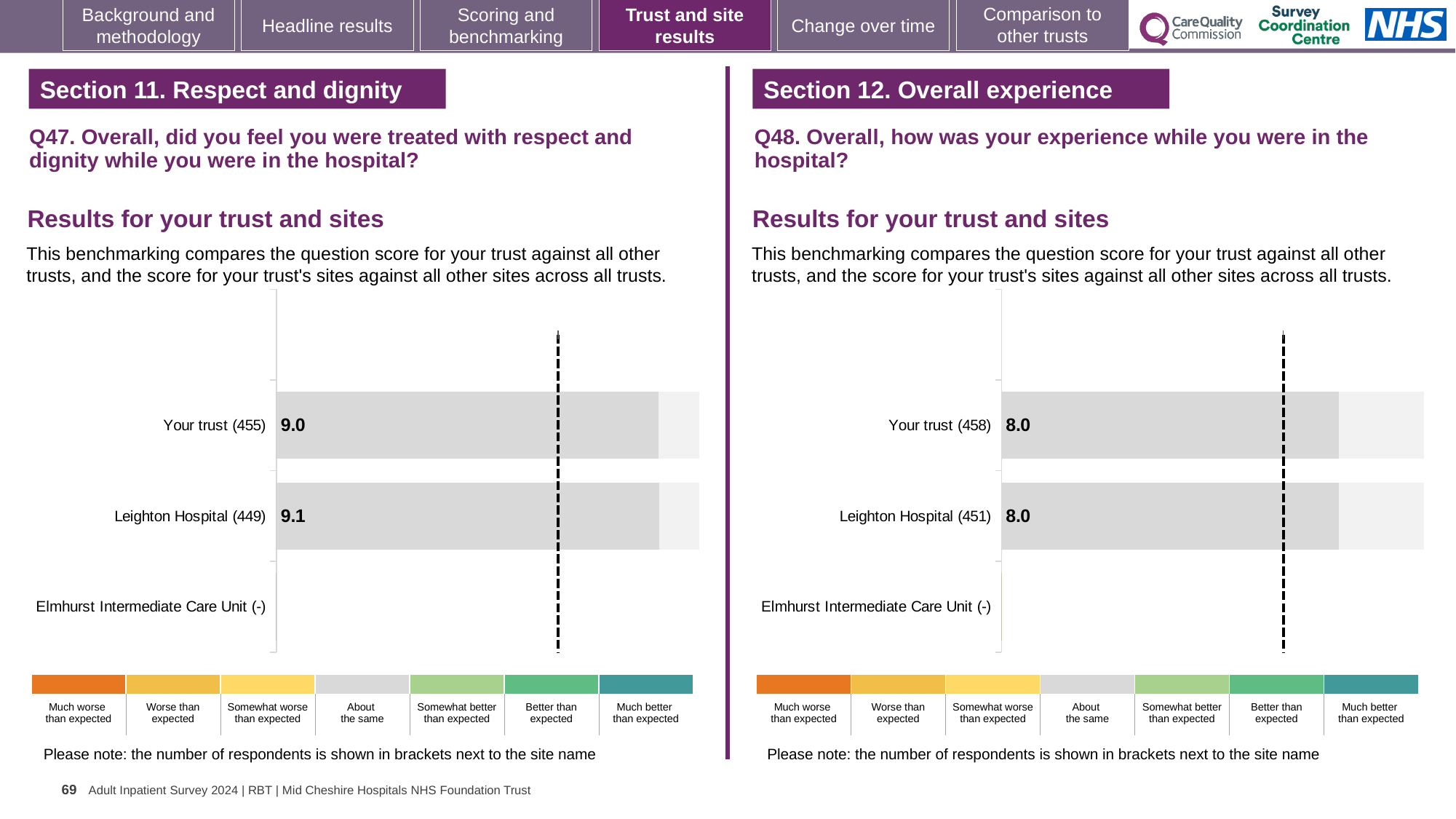
In the Q48 chart on the right, what is the difference between the Your trust score and the Leighton Hospital score? 0.0 In the Q47 chart on the left, what is the score for Your trust? 9.0 In the Q48 chart on the right, what is the score for Your trust? 8.0 In the Q48 chart on the right, what is the score for Leighton Hospital? 8.0 In the Q48 chart on the right, how many respondents are shown in brackets for Leighton Hospital? 451 How many site/trust rows are listed in the Q47 chart on the left? 3 In the Q47 chart on the left, how many respondents are shown in brackets for Your trust? 455 In the Q47 chart on the left, which row has no score shown? Elmhurst Intermediate Care Unit In the Q47 chart on the left, what is the difference between the Leighton Hospital score and the Your trust score? 0.1 What kind of chart is used for the Q48 results on the right? Bar chart In the Q47 chart on the left, what is the score for Leighton Hospital? 9.1 How many categories does the colour legend below the Q48 chart list? 7